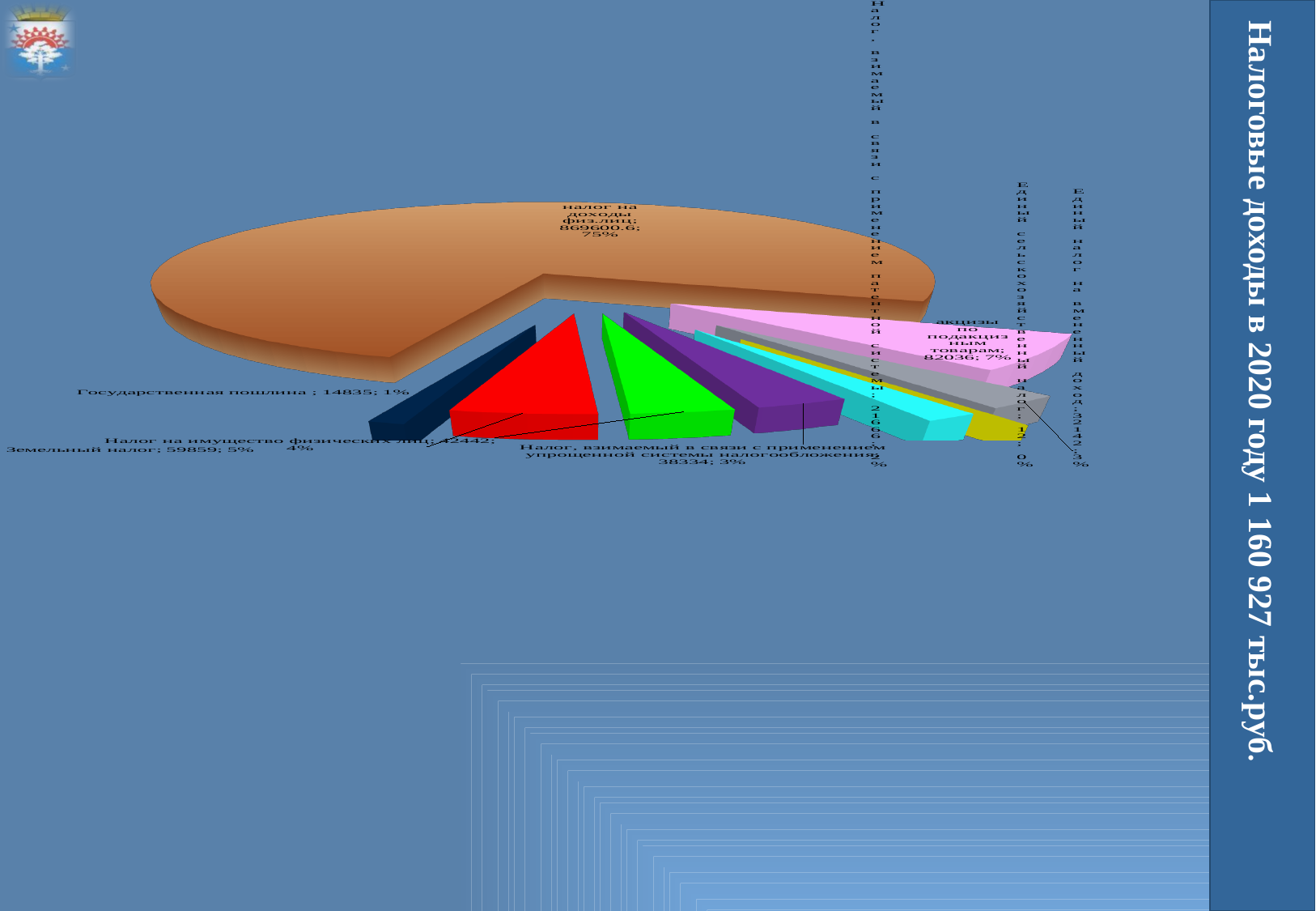
What is the value shown for налог на доходы физ.лиц? 869600.6 Which category has the largest slice of the pie? налог на доходы физ.лиц What is the value shown for Земельный налог? 59859 What is the value shown for Налог на имущество физических лиц? 42442 What share of the pie does Налог, взимаемый в связи с применением упрощенной системы налогообложения represent? 3% What is the difference between the values for акцизы по подакцизным товарам and Земельный налог? 22177 What share of the pie do акцизы по подакцизным товарам represent? 7% What share of the pie does налог на доходы физ.лиц represent? 75% Which is larger, Земельный налог or Налог на имущество физических лиц? Земельный налог What kind of chart is shown on the slide? pie chart What is the value shown for акцизы по подакцизным товарам? 82036 What is the value shown for Государственная пошлина? 14835